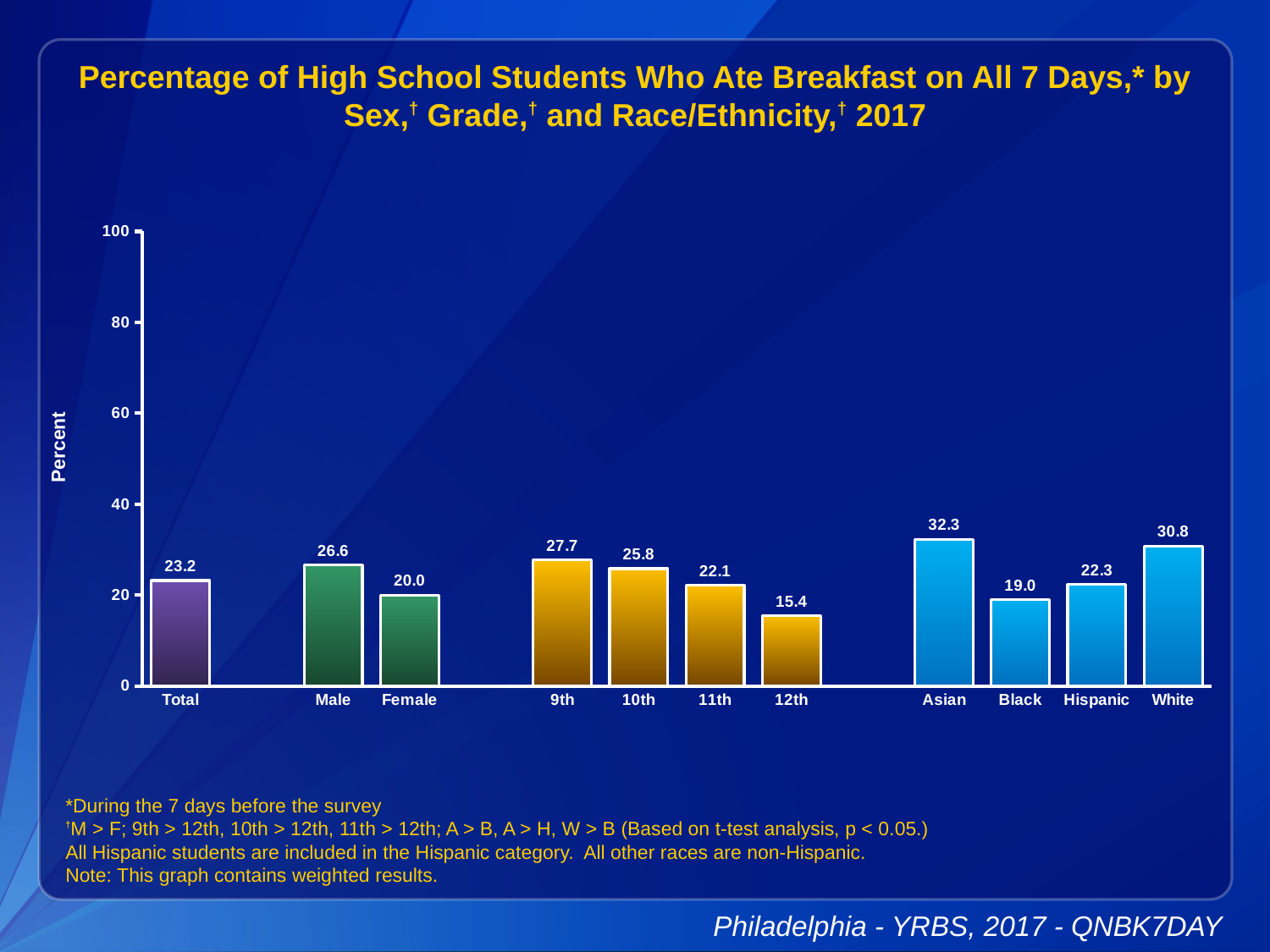
Which category has the highest value? Asian What is the value for Hispanic students? 22.3 How many bars are shown in the chart? 11 What is the value for 12th grade? 15.4 Which category has the lowest value? 12th What is the difference between the Male and Female values? 6.6 What is the value for Total? 23.2 What is the difference between the Asian and Black values? 13.3 What kind of chart is shown on the slide? bar chart Which is larger, the value for 9th grade or the value for 11th grade? 9th What is the value for Female? 20.0 Is the value for White greater or less than 20? greater